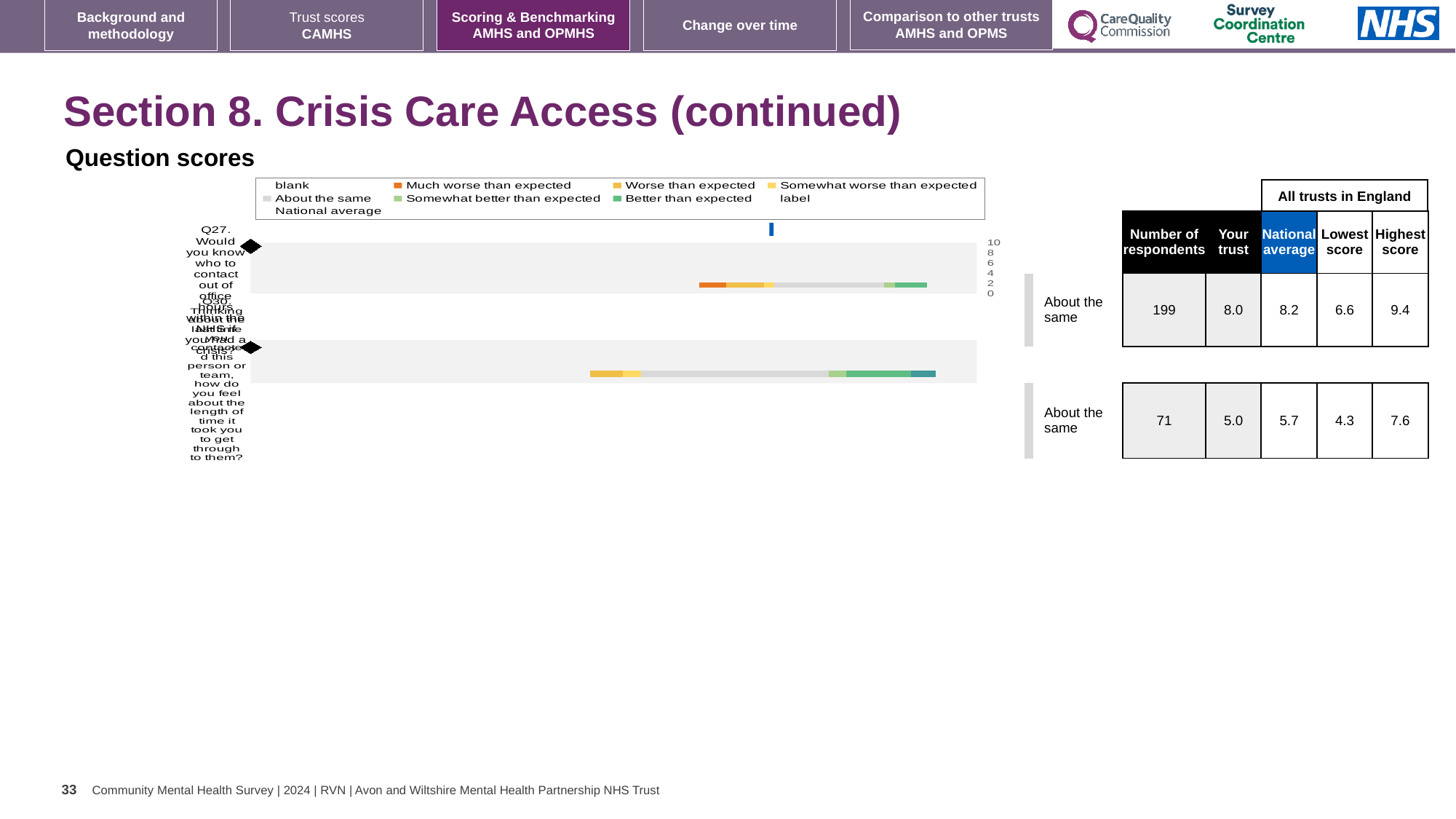
What kind of chart is used to show the question scores on this slide? bar chart According to the table beside the chart, how many respondents answered Q27? 199 How many questions are plotted in the question scores chart? 2 According to the table beside the chart, what is the lowest score for Q30 among all trusts in England? 4.3 According to the table beside the chart, what is the 'Your trust' score for Q27? 8.0 Which question has the higher 'Your trust' score in the table beside the chart, Q27 or Q30? Q27 What is the difference between the highest score and the lowest score for Q27 in the table beside the chart? 2.8 For Q27, which is larger in the table beside the chart: the 'Your trust' score or the national average? National average What colour does the chart legend use for 'Much worse than expected'? Orange What is the heading above the question scores chart? Question scores According to the table beside the chart, what is the national average for Q30? 5.7 By how much does the national average exceed the 'Your trust' score for Q30 in the table beside the chart? 0.7